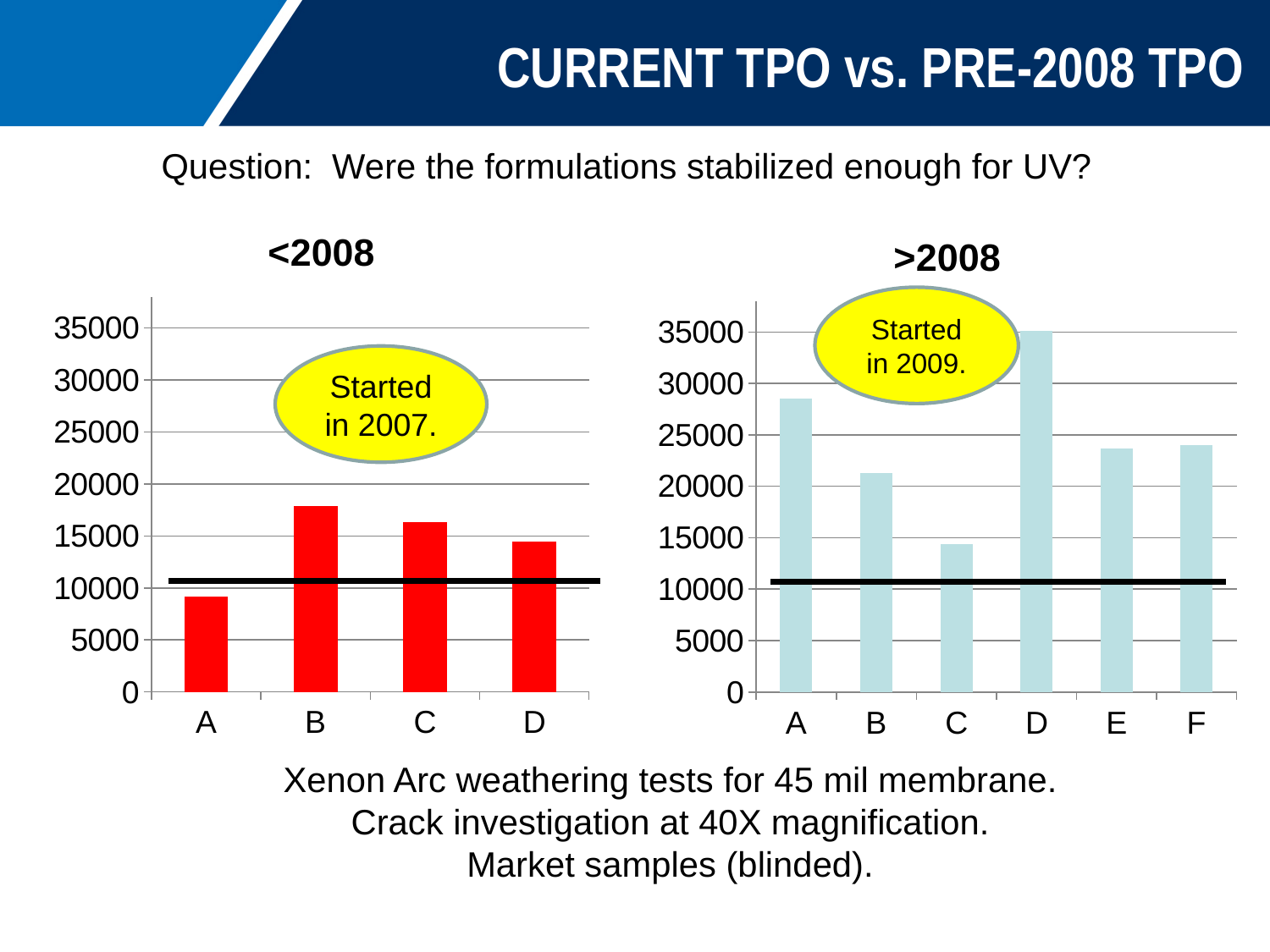
In the "<2008" chart, which category has the highest bar? B What colour are the bars in the "<2008" chart? red In the ">2008" chart, which is larger, the value for A or the value for B? A In the ">2008" chart, is the value for D greater or less than 30000? greater In the "<2008" chart, is the value for A greater or less than 10000? less In the ">2008" chart, how many categories are shown on the x axis? 6 In the "<2008" chart, which category has the lowest bar? A In the "<2008" chart, how many categories are shown on the x axis? 4 In the ">2008" chart, which category has the highest bar? D In the "<2008" chart, is the value for B greater or less than 15000? greater In the ">2008" chart, which category has the lowest bar? C What kind of chart is the "<2008" chart? bar chart